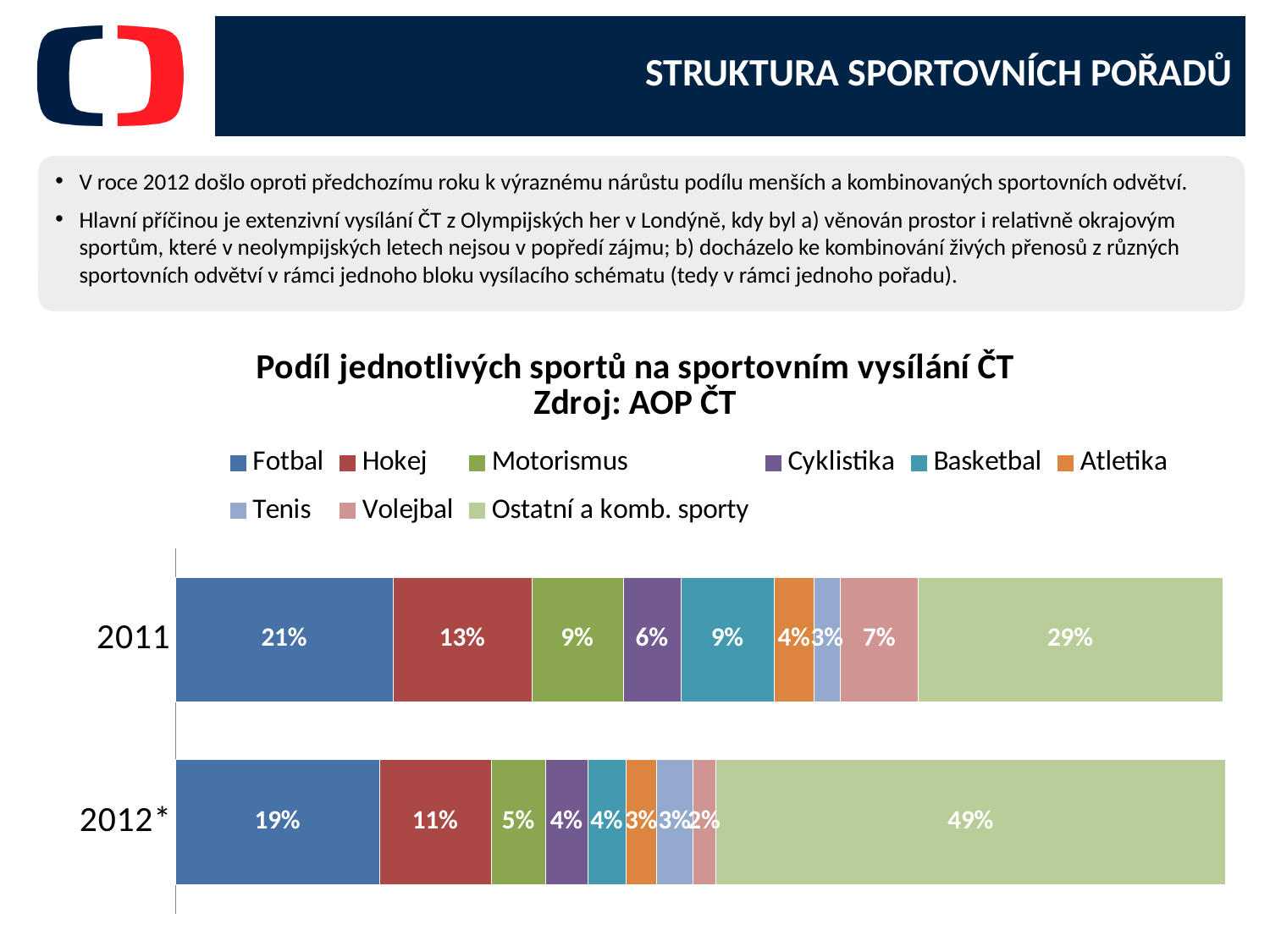
Which sport has the smallest share in 2012*? Volejbal What is the share of Ostatní a komb. sporty in 2012*? 49% What is the source given in the chart title? AOP ČT What is the share of Hokej in 2012*? 11% What is the share of Volejbal in 2011? 7% By how many percentage points did the share of Ostatní a komb. sporty increase from 2011 to 2012*? 20 percentage points How many series does the legend list? 9 Which is larger: the share of Motorismus in 2011 or in 2012*? 2011 What kind of chart is shown on the slide? Stacked bar chart Which sport has the largest share in 2012*? Ostatní a komb. sporty How many categories (years) are plotted on the chart? 2 What is the share of Fotbal in 2011? 21%